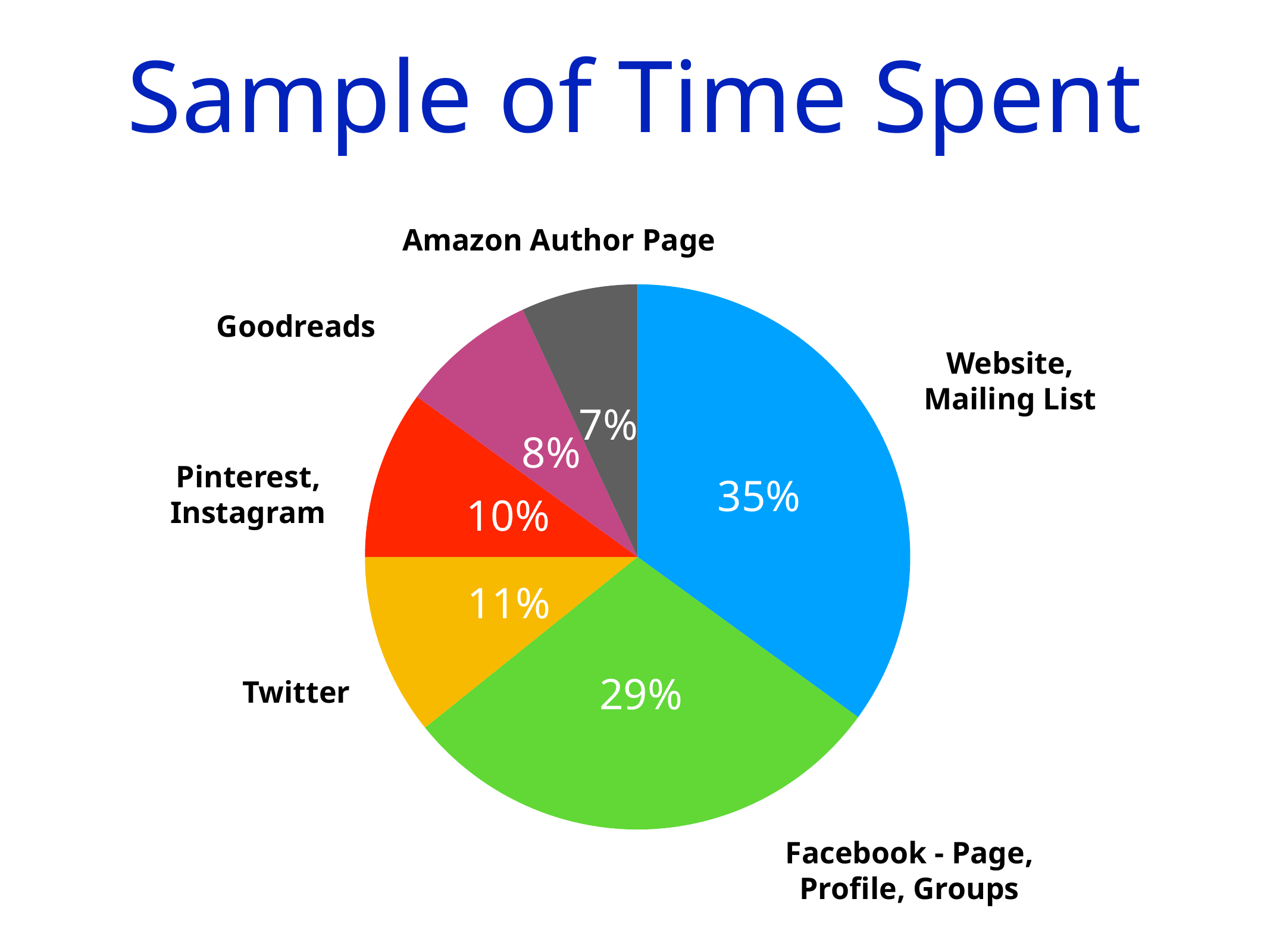
What share of time is spent on Website, Mailing List? 35% What share of time is spent on Amazon Author Page? 7% Which category has the smallest share of time spent? Amazon Author Page What share of time is spent on Twitter? 11% What kind of chart is shown on the slide? Pie chart Which category has the largest share of time spent? Website, Mailing List How many categories are shown in the pie chart? 6 What is the difference in percentage points between Website, Mailing List and Facebook - Page, Profile, Groups? 6 What share of time is spent on Pinterest, Instagram? 10% What share of time is spent on Facebook - Page, Profile, Groups? 29% Which has a larger share, Twitter or Goodreads? Twitter What share of time is spent on Goodreads? 8%